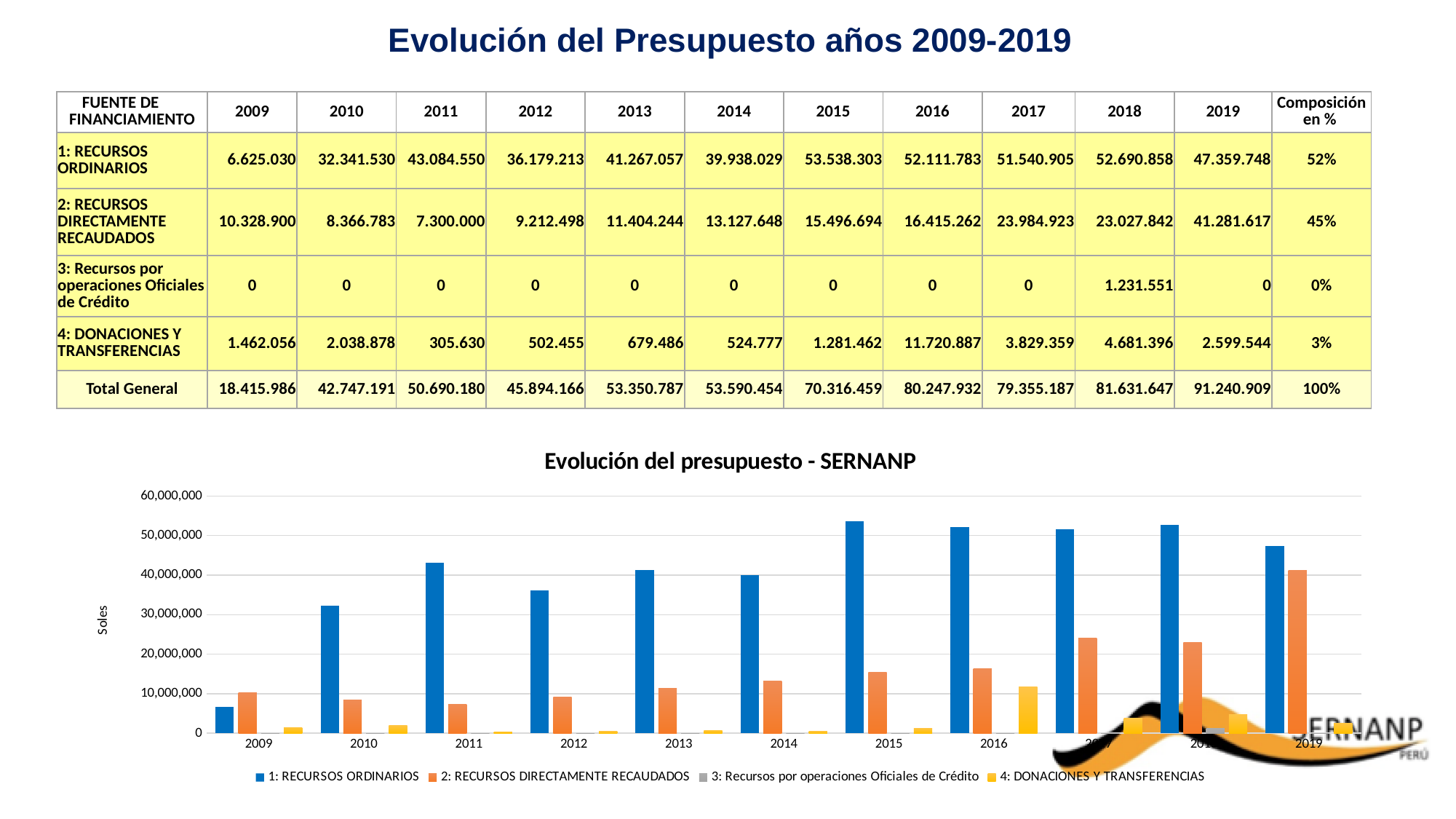
In the 'Evolución del presupuesto - SERNANP' chart, which year has the highest value for '4: DONACIONES Y TRANSFERENCIAS'? 2016 In the 'Evolución del presupuesto - SERNANP' chart, which series has the larger value in 2009: '1: RECURSOS ORDINARIOS' or '2: RECURSOS DIRECTAMENTE RECAUDADOS'? 2: RECURSOS DIRECTAMENTE RECAUDADOS In the 'Evolución del presupuesto - SERNANP' chart, which year has the highest value for '2: RECURSOS DIRECTAMENTE RECAUDADOS'? 2019 What is the label on the y axis of the 'Evolución del presupuesto - SERNANP' chart? Soles How many years are shown on the x axis of the 'Evolución del presupuesto - SERNANP' chart? 11 How many series does the legend of the 'Evolución del presupuesto - SERNANP' chart list? 4 In the 'Evolución del presupuesto - SERNANP' chart, is the value for '1: RECURSOS ORDINARIOS' in 2009 greater or less than 10,000,000? less What kind of chart is shown under the title 'Evolución del presupuesto - SERNANP'? bar chart In the 'Evolución del presupuesto - SERNANP' chart, do the values for '2: RECURSOS DIRECTAMENTE RECAUDADOS' rise or fall from 2013 to 2019? rise In the 'Evolución del presupuesto - SERNANP' chart, is the value for '2: RECURSOS DIRECTAMENTE RECAUDADOS' in 2019 greater or less than 30,000,000? greater In the 'Evolución del presupuesto - SERNANP' chart, is the value for '1: RECURSOS ORDINARIOS' in 2015 greater or less than 50,000,000? greater What colour are the bars for '1: RECURSOS ORDINARIOS' in the 'Evolución del presupuesto - SERNANP' chart? blue